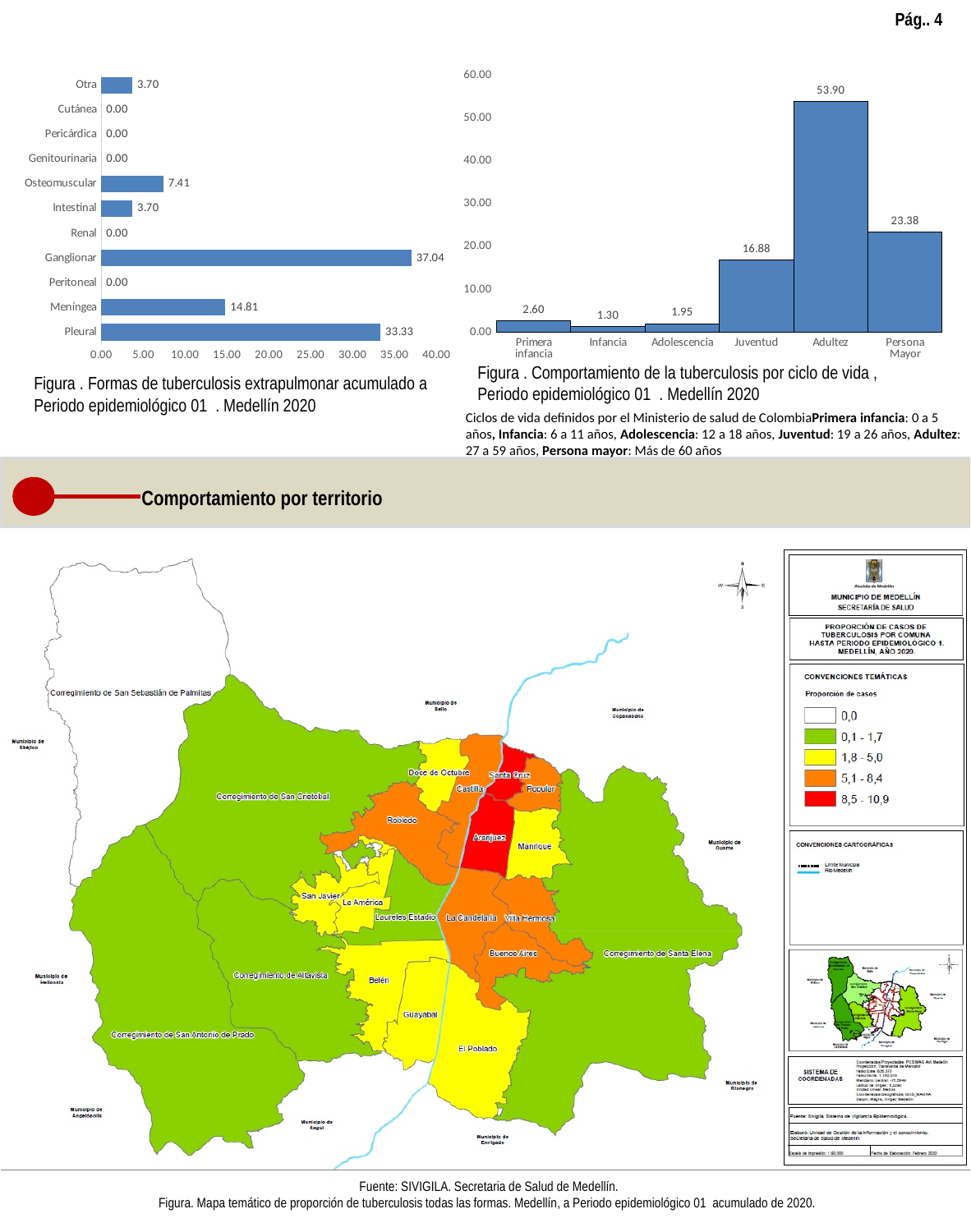
In the chart 'Comportamiento de la tuberculosis por ciclo de vida, Periodo epidemiológico 01. Medellín 2020', what is the value for Juventud? 16.88 In the chart 'Formas de tuberculosis extrapulmonar acumulado a Periodo epidemiológico 01. Medellín 2020', which category has the highest value? Ganglionar In the chart 'Formas de tuberculosis extrapulmonar acumulado a Periodo epidemiológico 01. Medellín 2020', what is the difference between the values for Ganglionar and Pleural? 3.71 In the chart 'Comportamiento de la tuberculosis por ciclo de vida, Periodo epidemiológico 01. Medellín 2020', what is the value for Adultez? 53.90 In the chart 'Comportamiento de la tuberculosis por ciclo de vida, Periodo epidemiológico 01. Medellín 2020', which category has the lowest value? Infancia In the chart 'Formas de tuberculosis extrapulmonar acumulado a Periodo epidemiológico 01. Medellín 2020', which is larger, Osteomuscular or Intestinal? Osteomuscular In the chart 'Formas de tuberculosis extrapulmonar acumulado a Periodo epidemiológico 01. Medellín 2020', what is the value for Ganglionar? 37.04 In the chart 'Comportamiento de la tuberculosis por ciclo de vida, Periodo epidemiológico 01. Medellín 2020', how many categories are shown on the x axis? 6 In the chart 'Formas de tuberculosis extrapulmonar acumulado a Periodo epidemiológico 01. Medellín 2020', how many categories are shown? 11 What kind of chart is 'Formas de tuberculosis extrapulmonar acumulado a Periodo epidemiológico 01. Medellín 2020'? Bar chart In the chart 'Comportamiento de la tuberculosis por ciclo de vida, Periodo epidemiológico 01. Medellín 2020', what is the difference between the values for Adultez and Persona Mayor? 30.52 In the chart 'Formas de tuberculosis extrapulmonar acumulado a Periodo epidemiológico 01. Medellín 2020', what is the value for Meníngea? 14.81